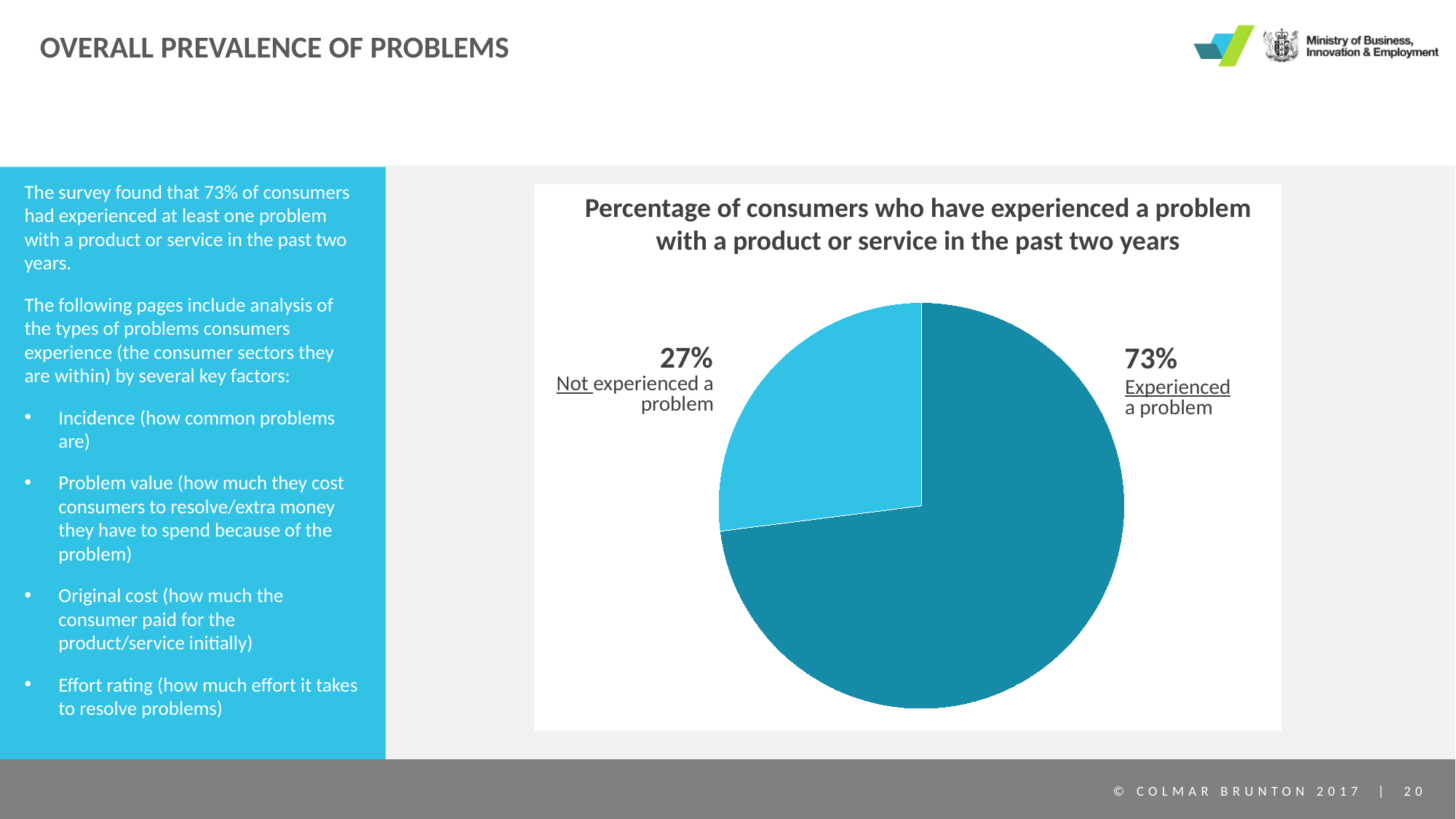
Which slice of the pie is the largest? Experienced a problem What kind of chart is shown on the slide? pie chart How many slices does the pie chart have? 2 What is the difference in percentage points between consumers who experienced a problem and those who did not? 46 Which slice is shown in the lighter blue colour? Not experienced a problem What percentage of consumers experienced a problem with a product or service in the past two years? 73% What is the title of the pie chart? Percentage of consumers who have experienced a problem with a product or service in the past two years What share of the pie does the 'Not experienced a problem' slice represent? 27% What percentage of consumers did not experience a problem with a product or service in the past two years? 27% Which slice of the pie is the smallest? Not experienced a problem Which is larger: the share of consumers who experienced a problem or the share who did not? Experienced a problem